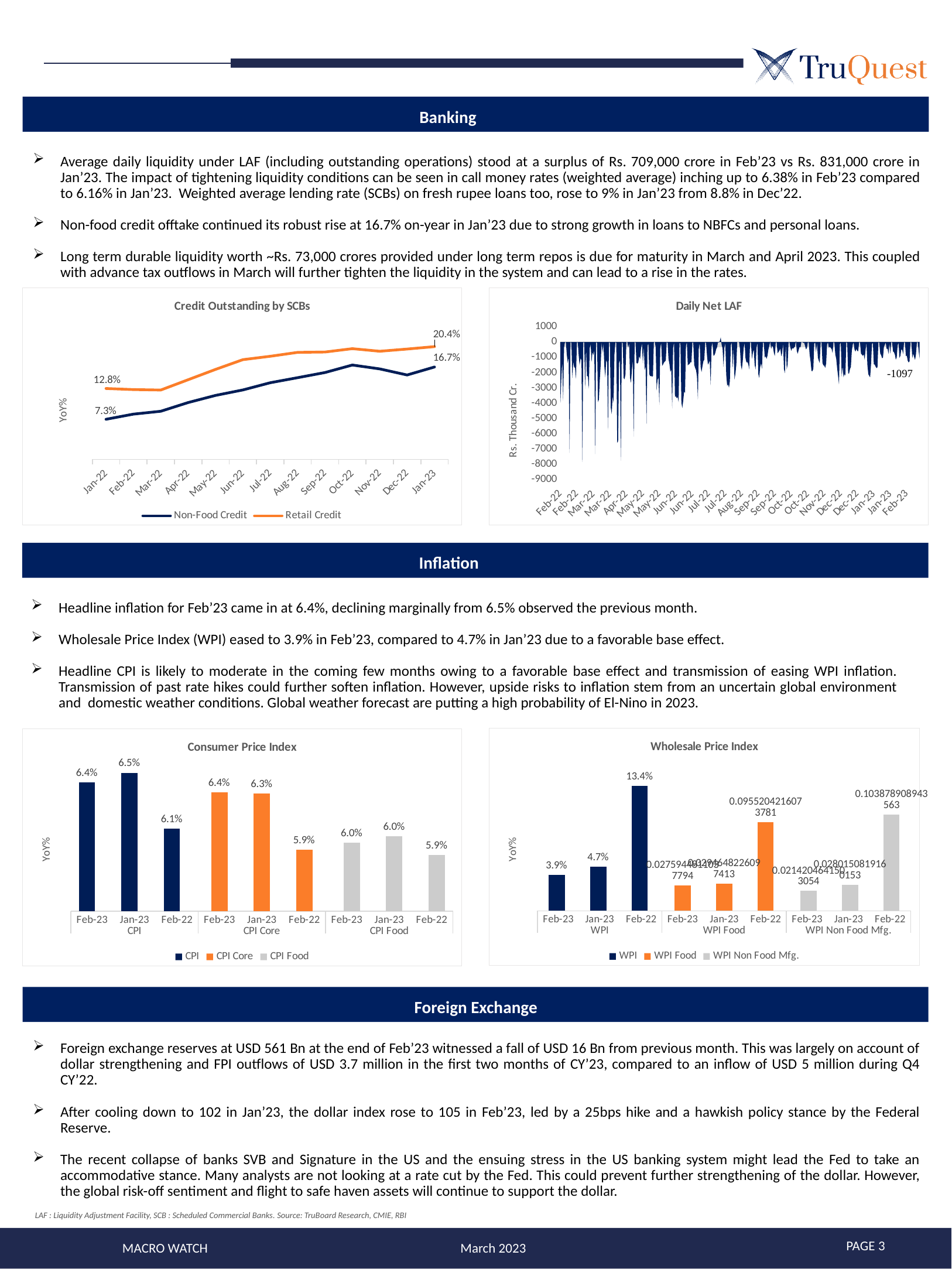
In the Consumer Price Index chart, which bar is the highest? Jan-23 CPI (6.5%) In the Credit Outstanding by SCBs chart, what was the Retail Credit value in Jan-22? 12.8% In the Wholesale Price Index chart, what was the WPI value for Feb-22? 13.4% In the Credit Outstanding by SCBs chart, what was the Non-Food Credit value in Jan-23? 16.7% What kind of chart is the Credit Outstanding by SCBs chart? Line chart In the Credit Outstanding by SCBs chart, how many series does the legend list? 2 In the Credit Outstanding by SCBs chart, do the Retail Credit values generally rise or fall from Jan-22 to Jan-23? Rise In the Credit Outstanding by SCBs chart, by how many percentage points did Non-Food Credit growth rise from Jan-22 to Jan-23? 9.4 percentage points In the Consumer Price Index chart, what was the CPI value for Jan-23? 6.5% In the Daily Net LAF chart, what is the value shown by the data label at the end of the series? -1097 In the Wholesale Price Index chart, what is the difference between the WPI values for Jan-23 and Feb-23? 0.8 percentage points In the Consumer Price Index chart, which is larger: CPI Core for Feb-23 or CPI Core for Feb-22? CPI Core for Feb-23